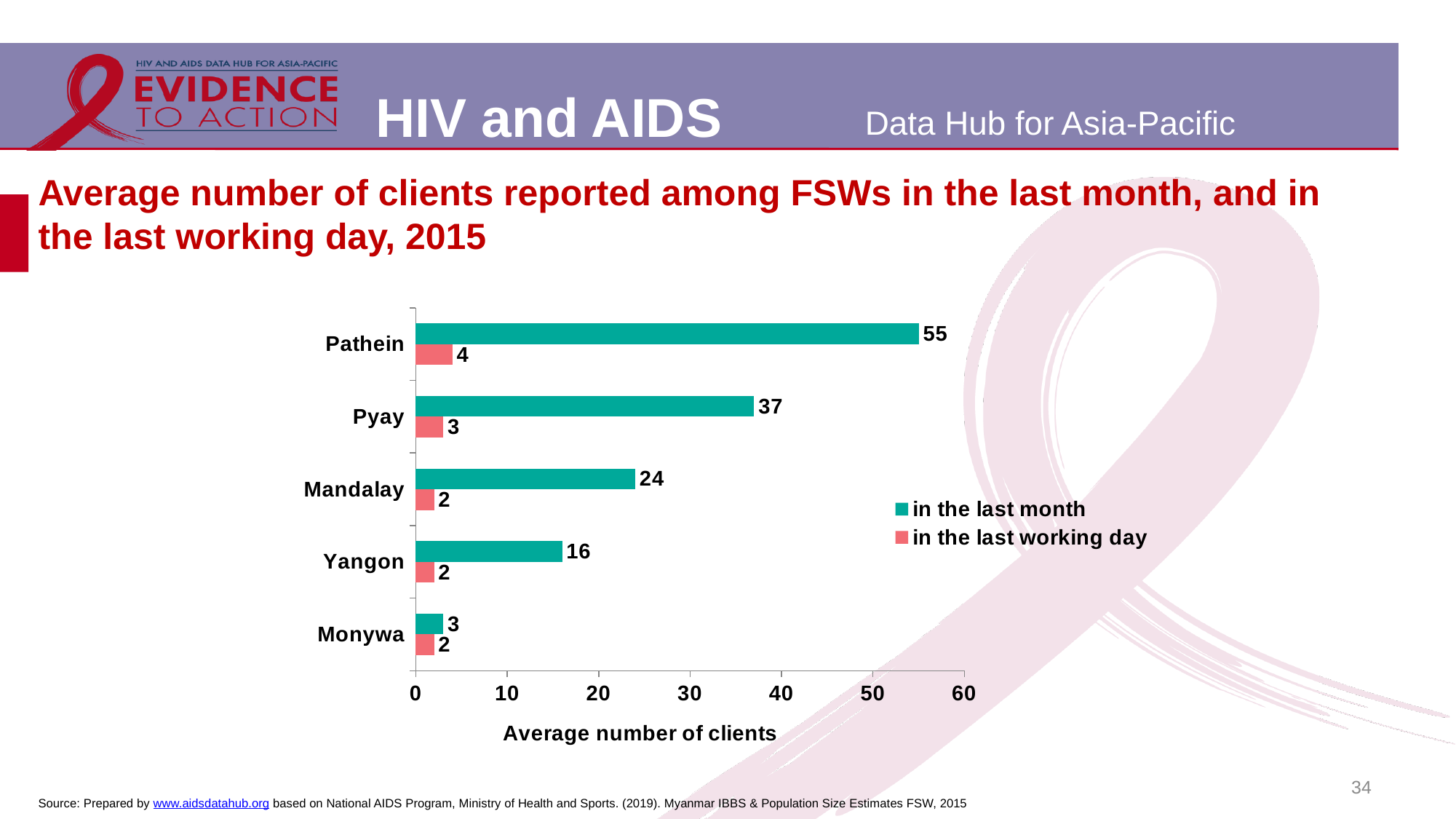
What is the x-axis title of the chart? Average number of clients What is the difference between the last-month values for Pathein and Pyay? 18 What kind of chart is shown on the slide? Bar chart What is the average number of clients in the last month for Mandalay? 24 Which city has the highest average number of clients in the last month? Pathein Which city has the lowest average number of clients in the last month? Monywa What is the average number of clients in the last working day for Pyay? 3 How many cities are shown on the chart? 5 How many series does the legend list? 2 Which is larger: the last-month value for Yangon or for Mandalay? Mandalay What is the average number of clients in the last month for Pathein? 55 Which colour represents 'in the last working day' in the legend? Red/pink